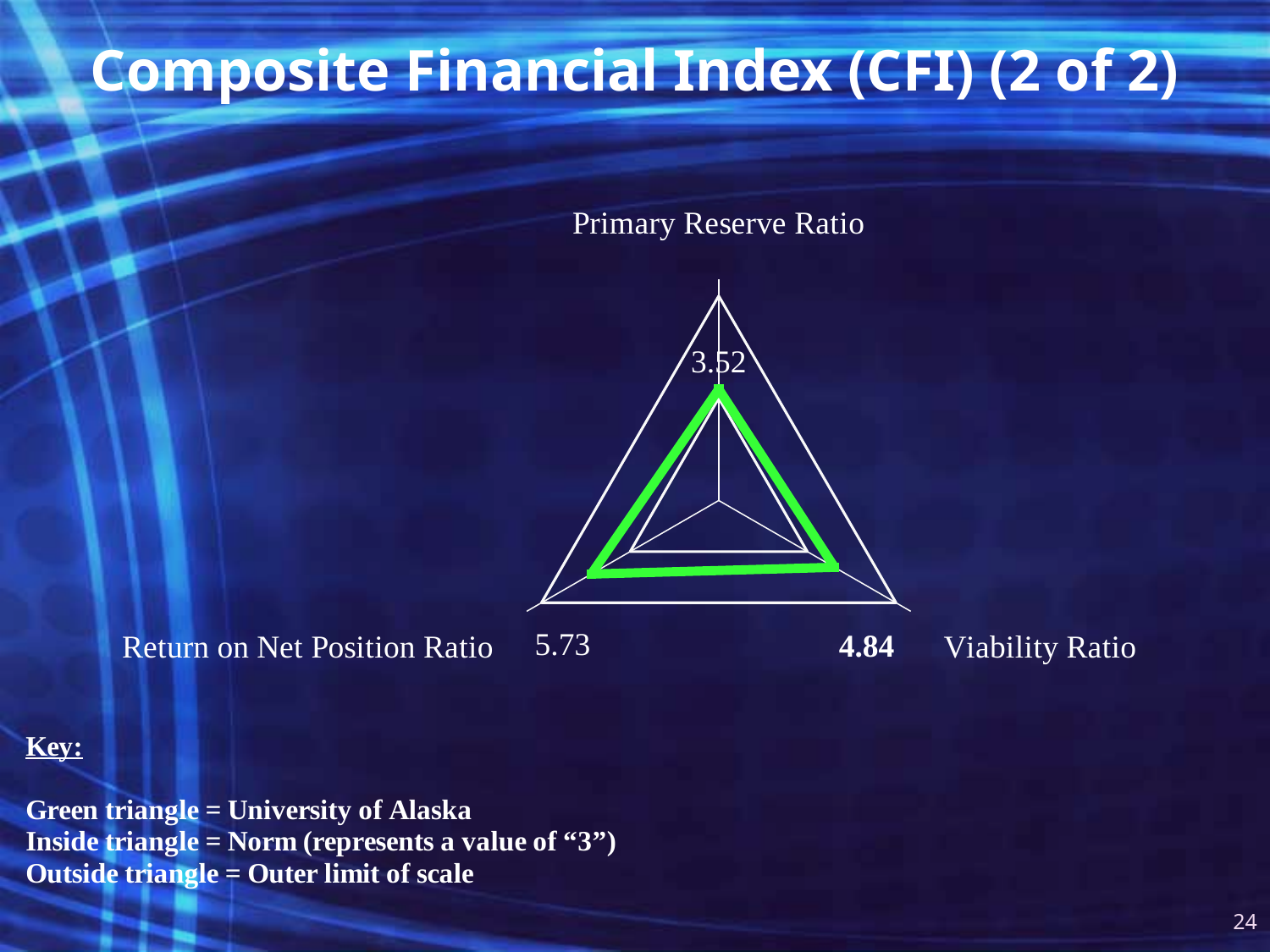
According to the key, what does the green triangle represent? University of Alaska What is the difference between the Return on Net Position Ratio and the Viability Ratio values? 0.89 How many ratios are plotted on the chart? 3 Is the Primary Reserve Ratio value greater or less than the norm value of 3? greater What is the difference between the Viability Ratio and the Primary Reserve Ratio values? 1.32 What is the University of Alaska's value for the Viability Ratio? 4.84 What kind of chart is shown on the slide? Radar chart Which is larger, the Primary Reserve Ratio or the Viability Ratio? Viability Ratio What is the University of Alaska's value for the Return on Net Position Ratio? 5.73 Which ratio has the lowest value for the University of Alaska? Primary Reserve Ratio What is the University of Alaska's value for the Primary Reserve Ratio? 3.52 Which ratio has the highest value for the University of Alaska? Return on Net Position Ratio